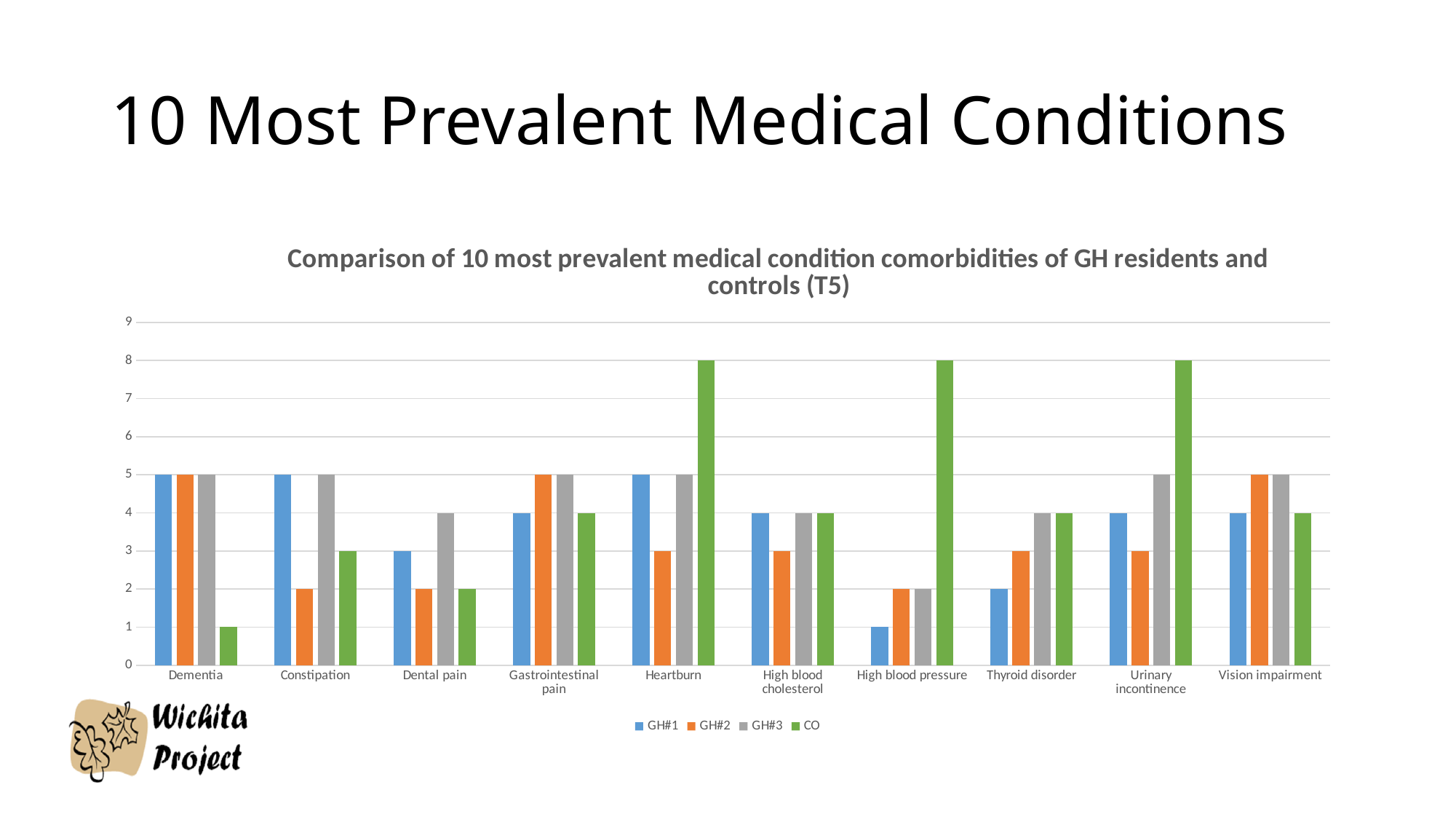
How many medical conditions are shown on the x axis? 10 What is the CO value for Dementia? 1 How many series does the legend list? 4 What is the GH#2 value for Thyroid disorder? 3 Is the CO value for Urinary incontinence greater or less than 6? greater What type of chart is shown on the slide? bar chart Which series is shown in green in the legend? CO What is the difference between the CO value and the GH#2 value for Heartburn? 5 Which is larger for Constipation, the GH#2 value or the CO value? CO What is the GH#1 value for High blood pressure? 1 Which condition has the lowest GH#1 value? High blood pressure What is the GH#3 value for Dental pain? 4